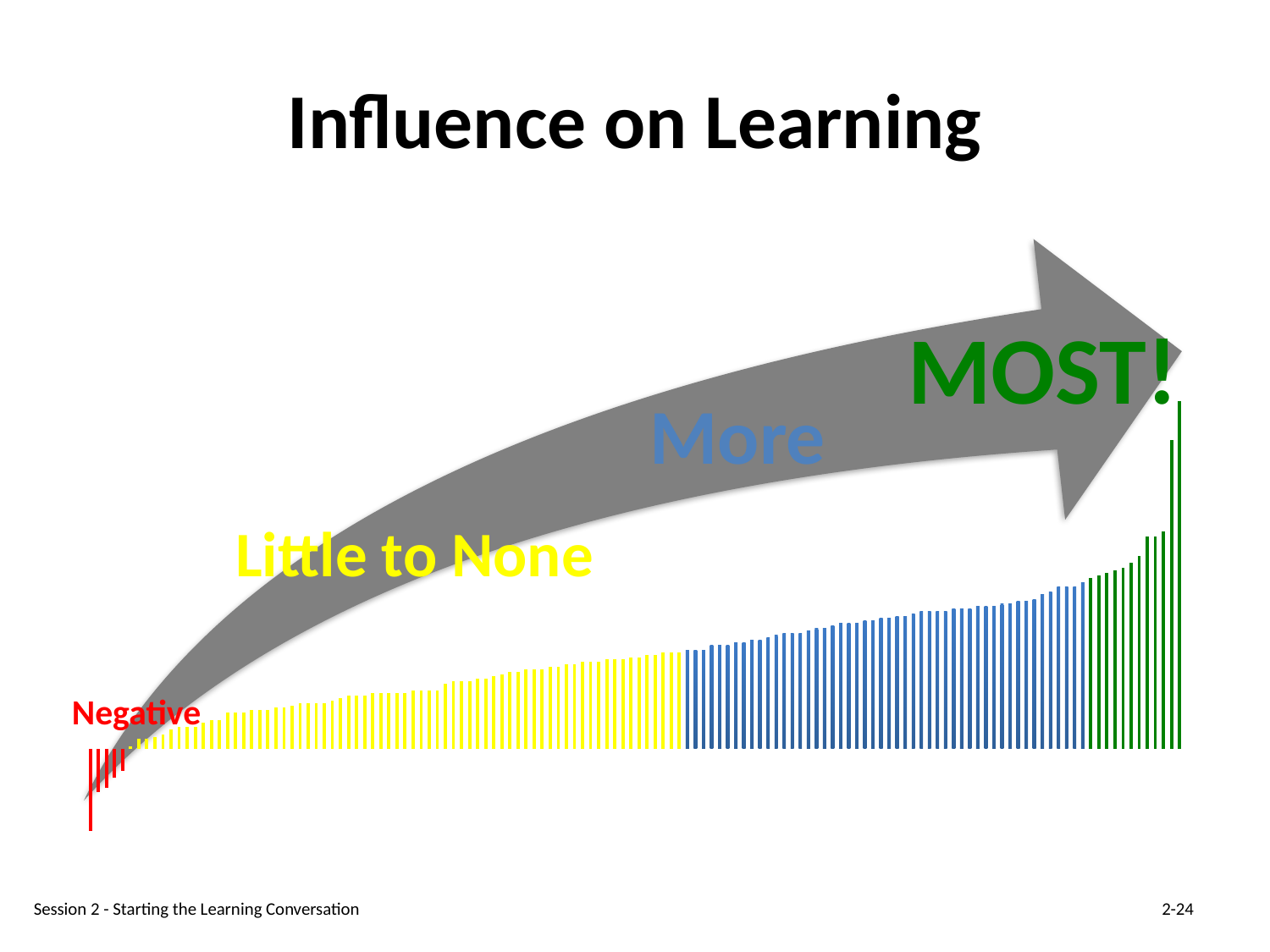
What kind of chart is shown on the slide? bar chart What is the title of the chart on the slide? Influence on Learning Are the green bars at the right of the chart taller or shorter than the yellow bars? taller Do the bar heights rise or fall from left to right across the chart? rise Are the blue bars taller or shorter than the green bars? shorter Which label is placed over the red bars at the left of the chart? Negative Which colour group of bars contains the tallest bars in the chart? green Which colour group of bars extends below the baseline in the chart? red